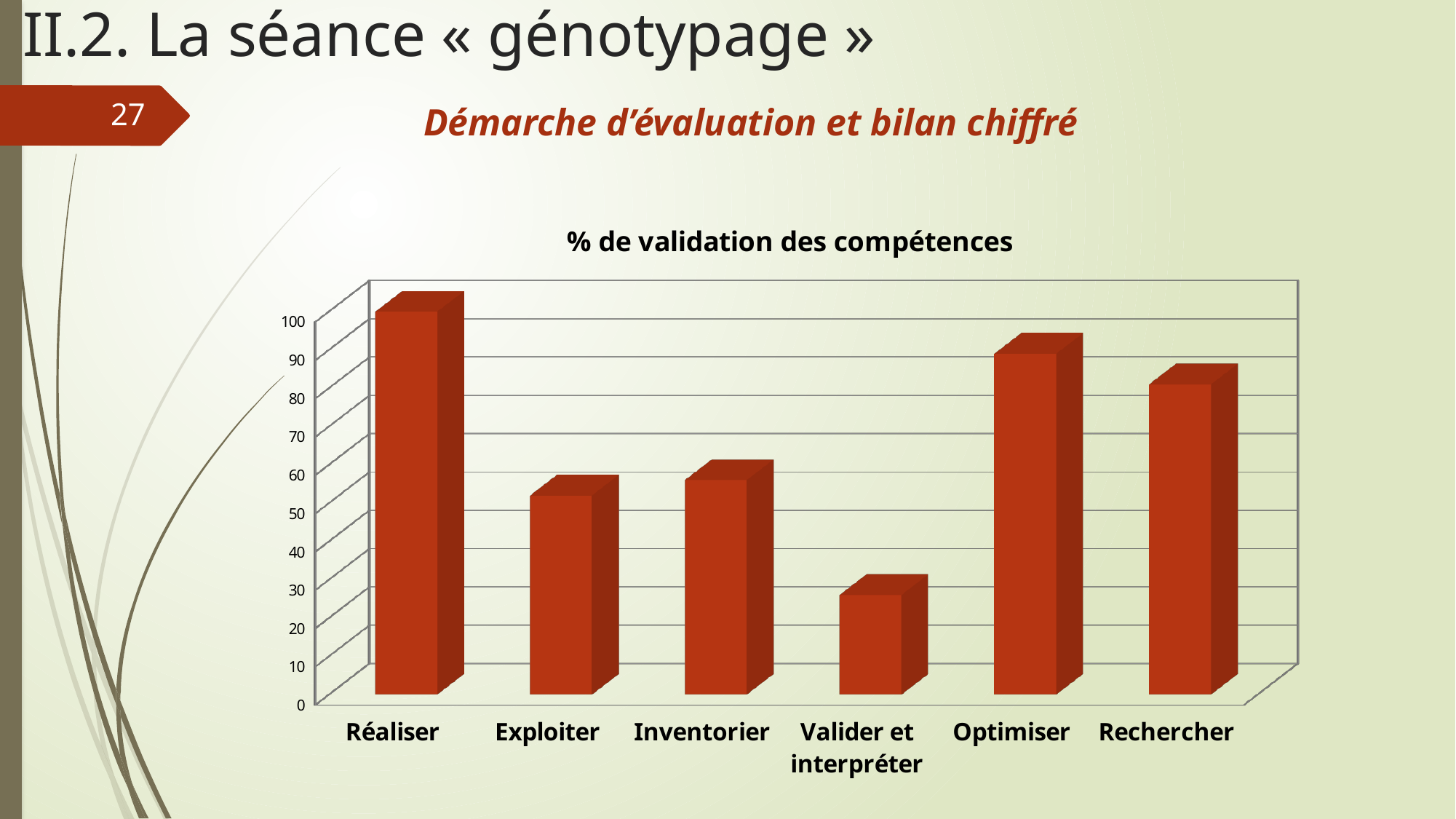
Is the value for Optimiser greater or less than 80? greater Is the value for Exploiter greater or less than 60? less Is the value for Inventorier greater or less than 50? greater What is the title of the chart? % de validation des compétences Which has the larger value, Optimiser or Rechercher? Optimiser How many categories are shown on the x axis of the chart? 6 Which category has the lowest value in the chart? Valider et interpréter What kind of chart is shown on the slide? bar chart Which category has the highest value in the chart? Réaliser